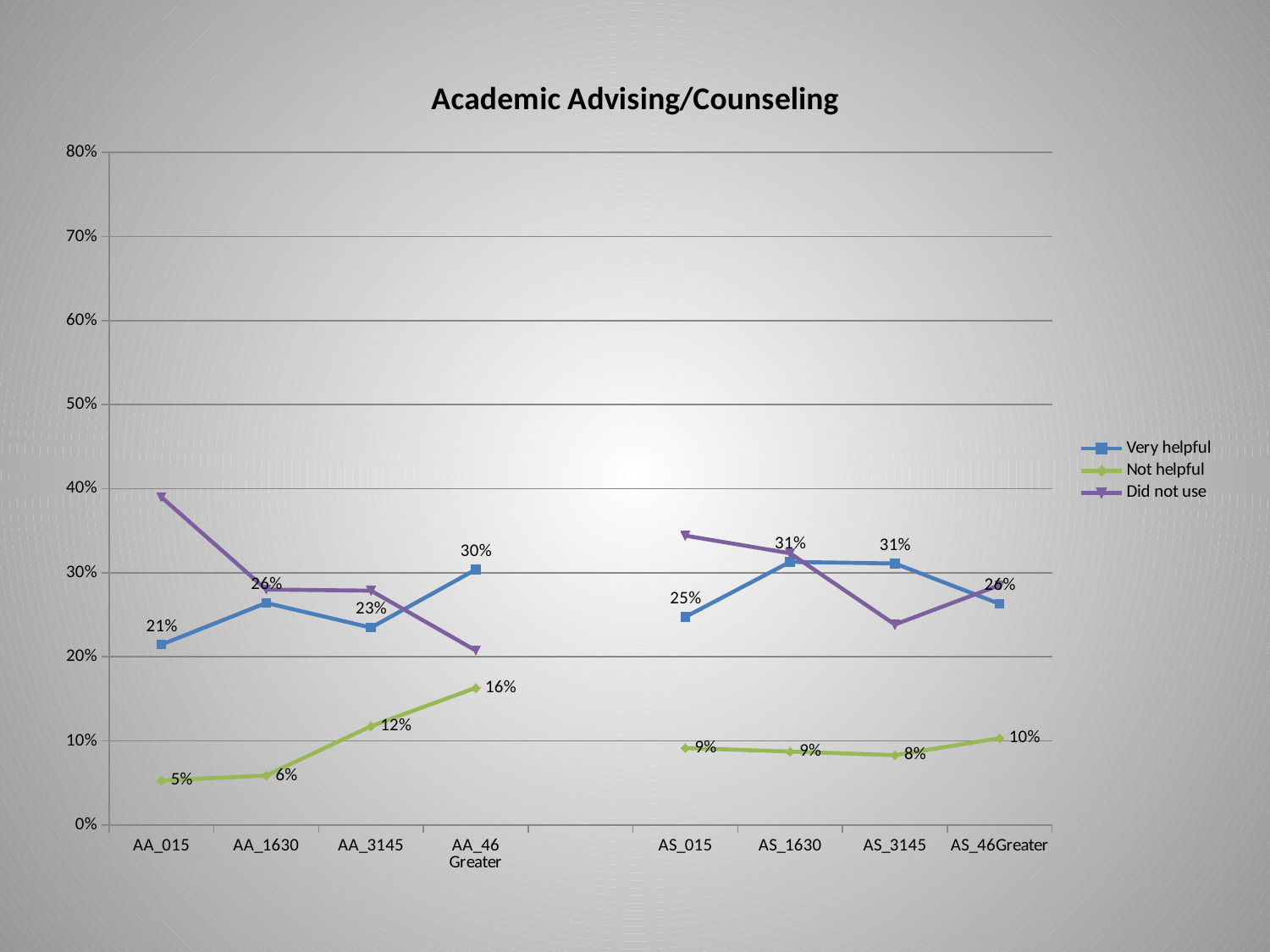
What is the Very helpful value for AA_46 Greater? 30% What is the Not helpful value for AS_3145? 8% What type of chart is shown on the slide? line chart Which is larger, the Very helpful value for AS_1630 or for AA_1630? AS_1630 Which category has the lowest Not helpful value? AA_015 How many series does the legend list? 3 Is the Did not use value for AA_015 greater or less than 30%? greater Does the Not helpful series rise or fall from AA_015 to AA_46 Greater? rise What is the difference between the Very helpful values for AA_46 Greater and AA_015? 9% What is the title of the chart? Academic Advising/Counseling What is the Very helpful value for AS_015? 25% Which category has the highest Not helpful value? AA_46 Greater